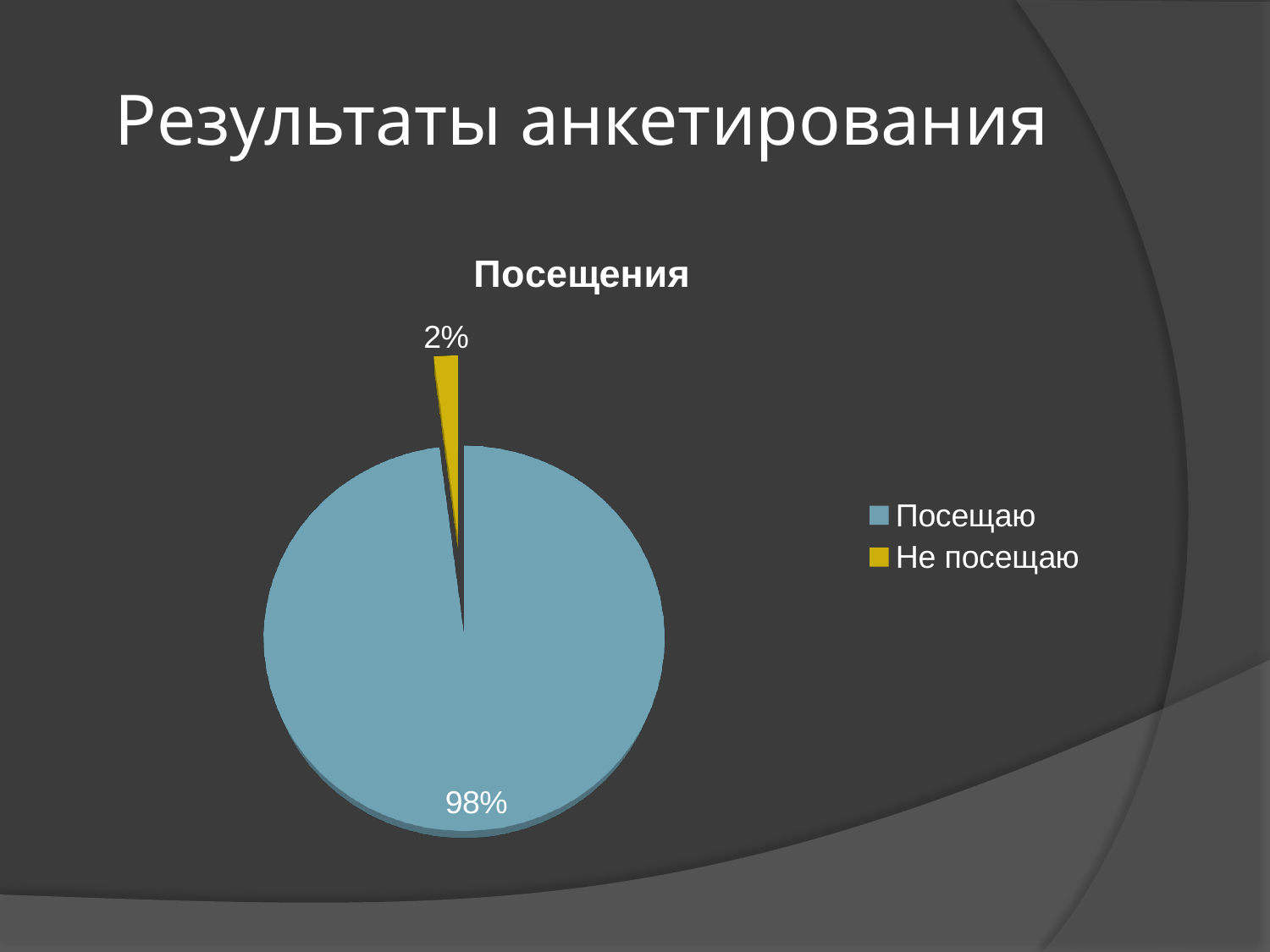
What kind of chart is shown on the slide? pie chart What share of the pie does "Не посещаю" take? 2% How many entries does the legend list? 2 What is the difference in percentage points between "Посещаю" and "Не посещаю"? 96 Which category has the smallest slice of the pie? Не посещаю Which is larger, the slice for "Посещаю" or the slice for "Не посещаю"? Посещаю What is the title of the chart? Посещения What share of the pie does "Посещаю" take? 98% Which category has the largest slice of the pie? Посещаю How many slices does the pie chart have? 2 What colour is the slice for "Не посещаю"? yellow